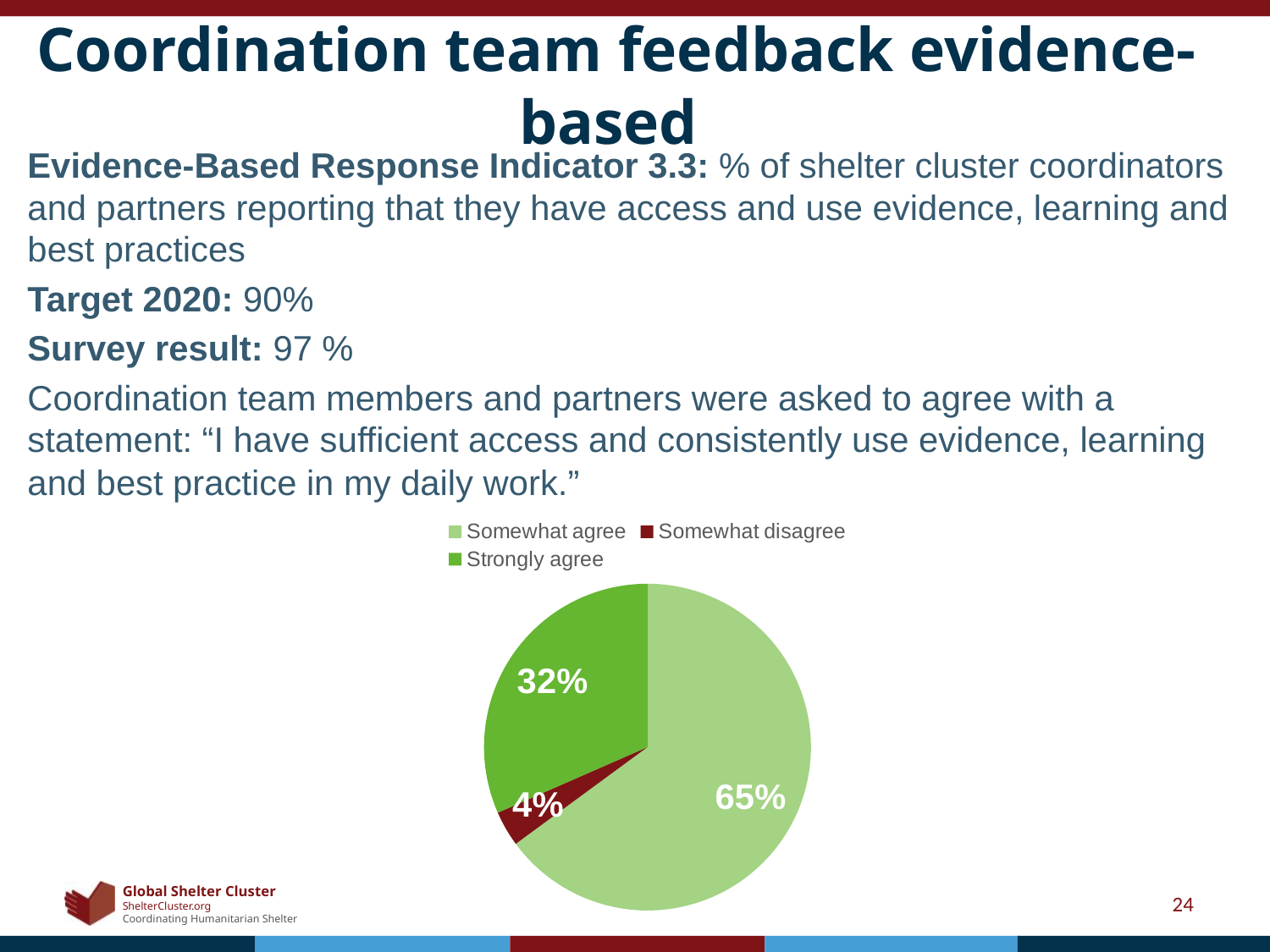
What is the difference in percentage points between "Somewhat agree" and "Strongly agree"? 33 What is the combined share of "Somewhat agree" and "Strongly agree"? 97% Which response category has the smallest share of the pie? Somewhat disagree What percentage of respondents selected "Strongly agree"? 32% What colour is the "Somewhat disagree" slice in the pie chart? Dark red What percentage of respondents selected "Somewhat agree"? 65% How many entries does the chart legend list? 3 What kind of chart is shown on the slide? Pie chart What percentage of respondents selected "Somewhat disagree"? 4% Which response category has the largest share of the pie? Somewhat agree Which is larger: the share for "Strongly agree" or the share for "Somewhat disagree"? Strongly agree How many slices does the pie chart have? 3